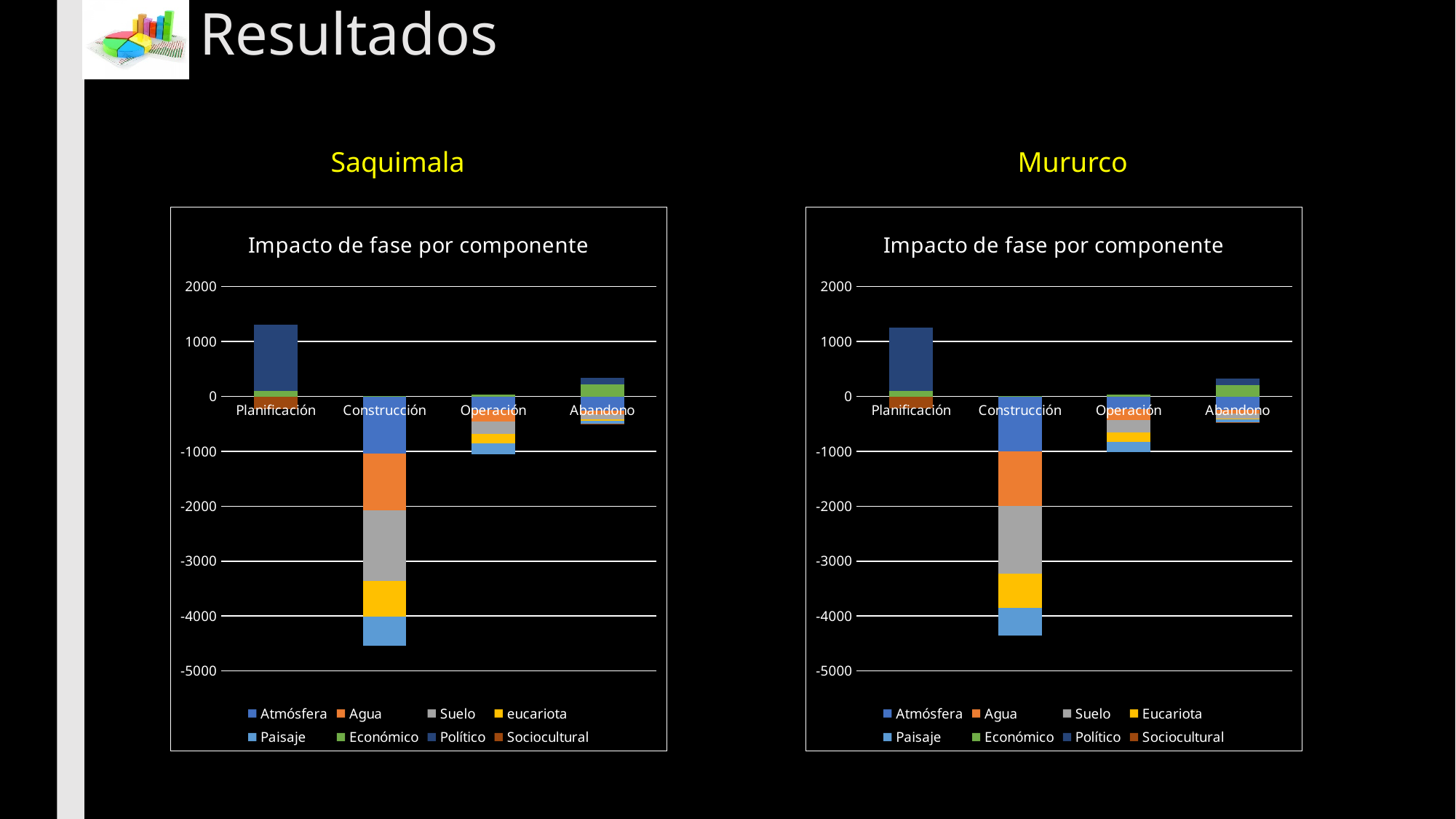
In the Saquimala chart, which series is shown in yellow according to the legend? eucariota What is the title of the Mururco chart? Impacto de fase por componente In the Mururco chart, which phase has the largest positive stacked bar? Planificación In the Mururco chart, is the top of the Planificación stacked bar greater or less than 1000? greater In the Saquimala chart, is the top of the Planificación stacked bar greater or less than 1000? greater In the Mururco chart, is the bottom of the Construcción stacked bar greater or less than -4000? less In the Saquimala chart, which phase has the largest negative stacked bar? Construcción How many phases (categories) are shown on the x axis of the Mururco chart? 4 How many series does the legend of the Saquimala chart list? 8 What kind of chart is the Saquimala chart? Stacked bar chart